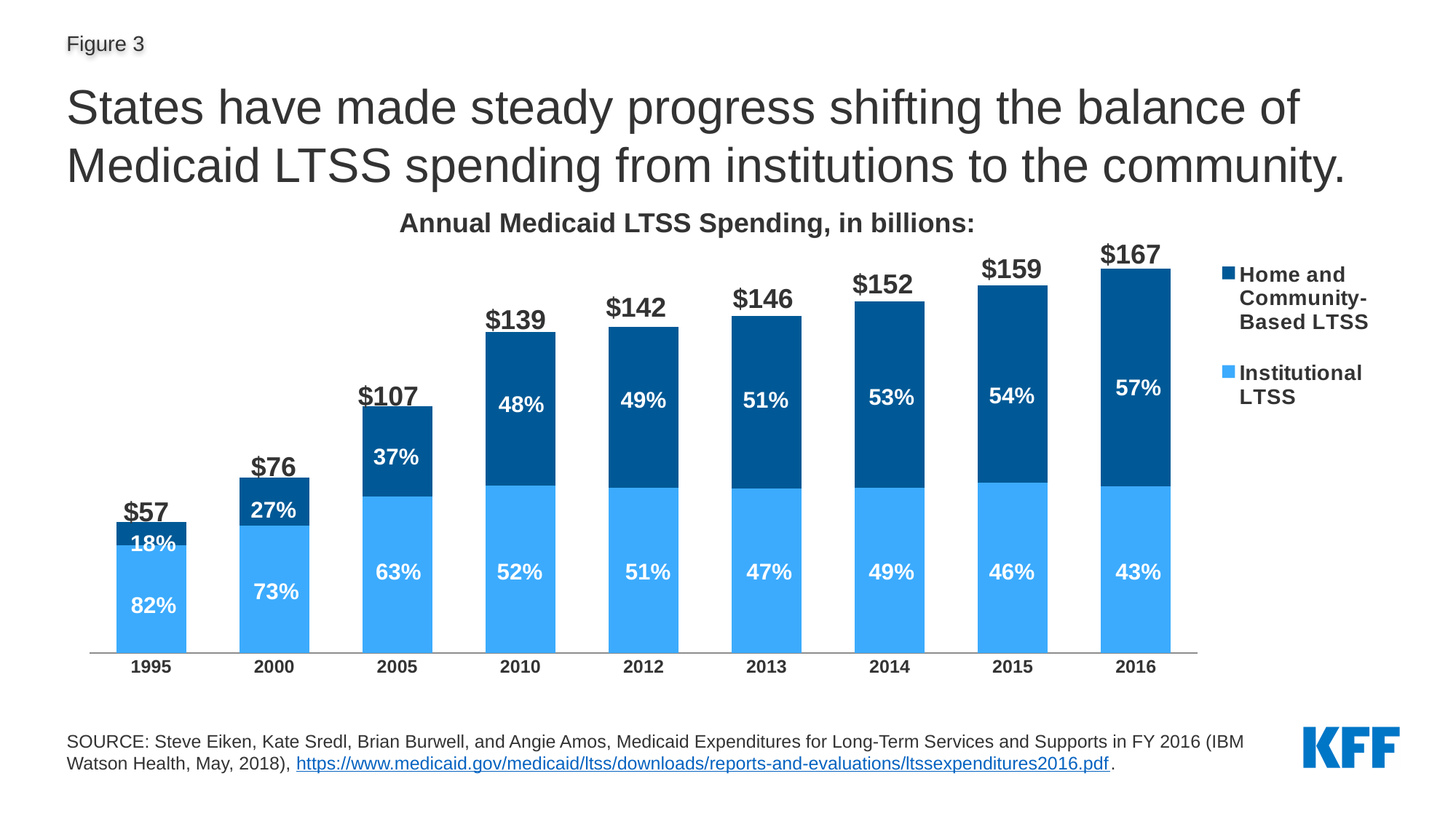
Does total annual Medicaid LTSS spending rise or fall from 1995 to 2016? Rise How many years are shown on the x axis? 9 What share of Medicaid LTSS spending went to Institutional LTSS in 1995? 82% What kind of chart is shown on the slide? Stacked bar chart What was the total annual Medicaid LTSS spending in 2010? $139 Which year has the highest total annual Medicaid LTSS spending? 2016 Which is larger in 2005: the Institutional LTSS share or the Home and Community-Based LTSS share? Institutional LTSS How much higher is total Medicaid LTSS spending in 2016 than in 1995? $110 How many series does the legend list? 2 Which series is shown in the darker blue colour? Home and Community-Based LTSS What share of Medicaid LTSS spending went to Home and Community-Based LTSS in 2016? 57% Which year has the lowest total annual Medicaid LTSS spending? 1995